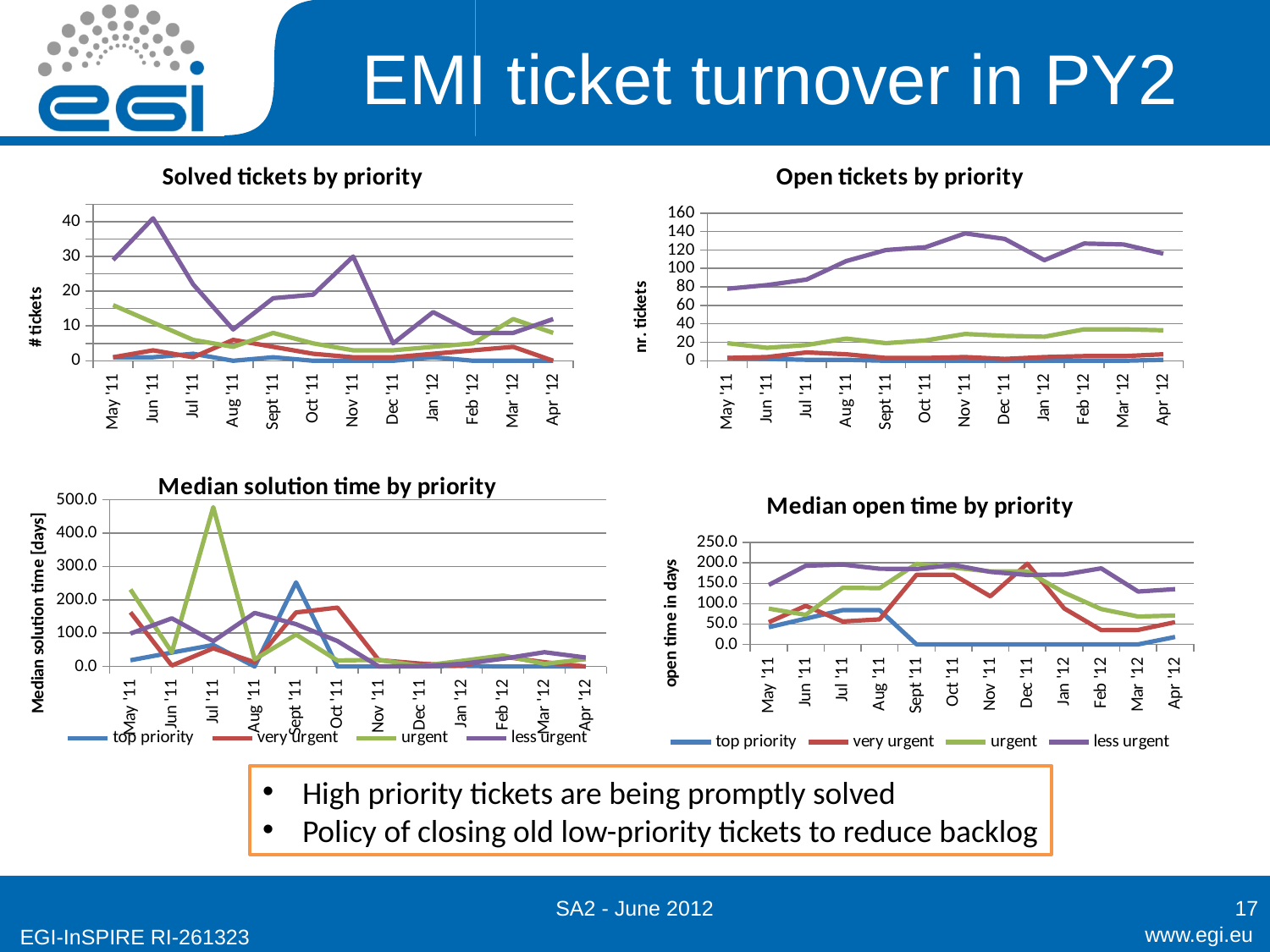
In the "Open tickets by priority" chart, how many months are plotted along the x axis? 12 In the "Median solution time by priority" chart, in which month does the urgent series reach its highest value? Jul '11 How many charts are shown on the slide? 4 What kind of chart is "Solved tickets by priority"? line chart In the "Open tickets by priority" chart, does the purple line rise or fall from May '11 to Nov '11? rise In the "Open tickets by priority" chart, is the value of the purple line in Nov '11 greater or less than 120? greater In the "Median solution time by priority" chart, is the value for urgent in Jul '11 greater or less than 400.0? greater In the "Median solution time by priority" chart, how many series does the legend list? 4 What is the y-axis label of the "Open tickets by priority" chart? nr. tickets In the "Median open time by priority" chart, is the value for very urgent in Dec '11 greater or less than 150.0? greater